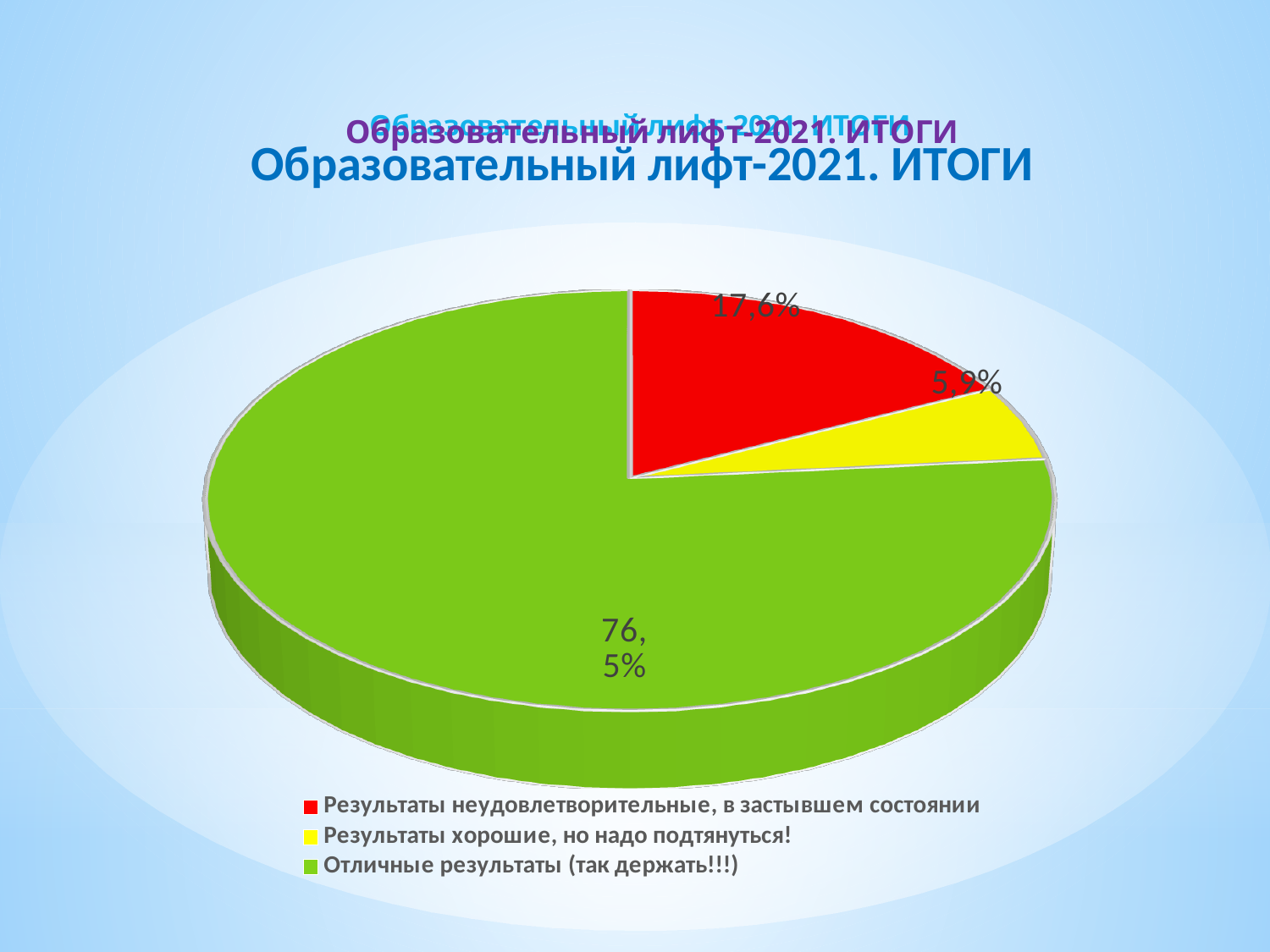
What colour is the slice for "Отличные результаты (так держать!!!)"? green What is the difference between the shares for "Результаты неудовлетворительные, в застывшем состоянии" and "Результаты хорошие, но надо подтянуться!"? 11,7% What share of the pie is labelled for "Результаты хорошие, но надо подтянуться!"? 5,9% What is the title of the slide? Образовательный лифт-2021. ИТОГИ What share of the pie is labelled for "Отличные результаты (так держать!!!)"? 76,5% What share of the pie is labelled for "Результаты неудовлетворительные, в застывшем состоянии"? 17,6% Which is larger: the slice for "Результаты неудовлетворительные, в застывшем состоянии" or the slice for "Результаты хорошие, но надо подтянуться!"? Результаты неудовлетворительные, в застывшем состоянии How many entries does the legend list? 3 Which category has the largest slice of the pie? Отличные результаты (так держать!!!) Which category has the smallest slice of the pie? Результаты хорошие, но надо подтянуться! How many slices does the pie chart have? 3 What kind of chart is shown on the slide? pie chart